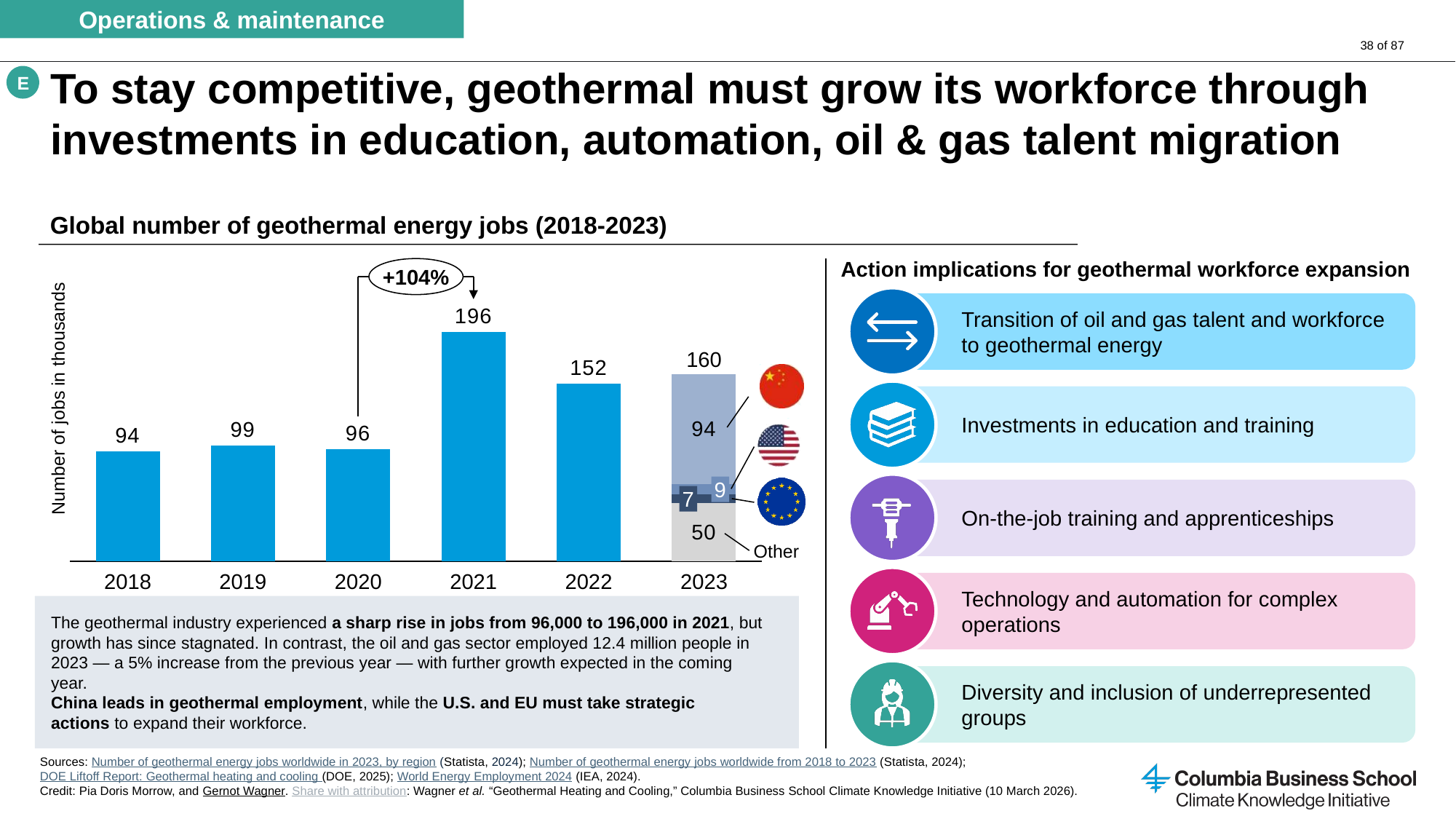
In the 2023 stacked bar, what value is shown for the 'Other' segment? 50 Which year has a larger value, 2022 or 2023? 2023 Which year has the lowest number of geothermal energy jobs in the chart? 2018 What kind of chart is used to show the global number of geothermal energy jobs? Bar chart What is the global number of geothermal energy jobs (in thousands) shown for 2021? 196 What is the value shown for 2018 in the geothermal jobs chart? 94 What percentage change is annotated between 2020 and 2021 in the chart? +104% Which year has the highest number of geothermal energy jobs in the chart? 2021 What is the difference between the 2021 and 2020 values in the geothermal jobs chart? 100 In the 2023 stacked bar, what value is shown for China? 94 What is the title of the chart on the slide? Global number of geothermal energy jobs (2018-2023) How many years are shown on the x axis of the geothermal jobs chart? 6